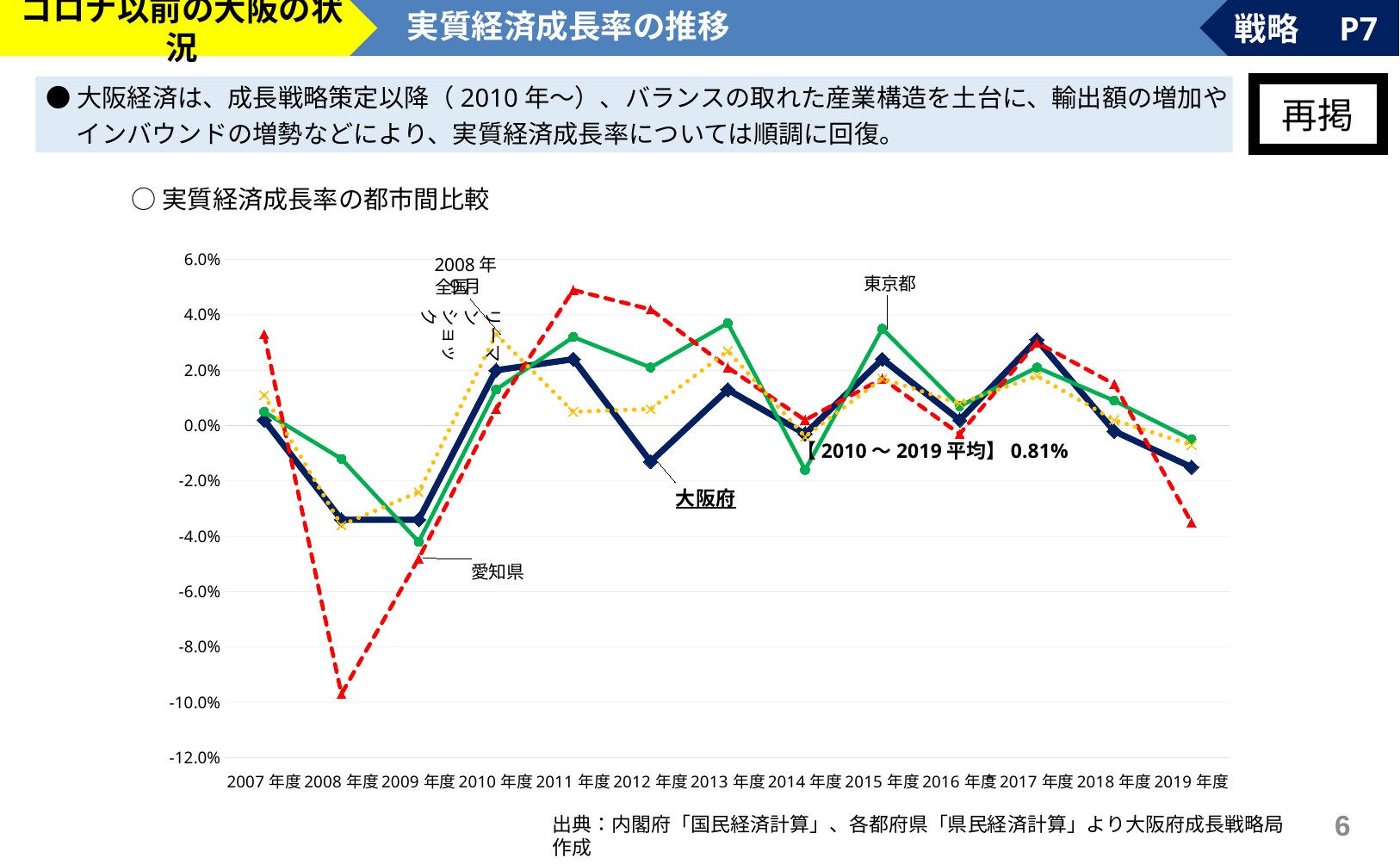
Is the value for 東京都 in 2014年度 greater or less than 0.0%? less In 2015年度, which is larger: the value for 東京都 or the value for 大阪府? 東京都 Is the value for 愛知県 in 2008年度 greater or less than -8.0%? less Which series is drawn as a red dashed line in the chart? 愛知県 Is the value for 大阪府 in 2012年度 greater or less than 0.0%? less What value is printed on the chart for the 2010～2019 average? 0.81% What is the title printed above the chart? 実質経済成長率の都市間比較 How many fiscal years are plotted along the x axis of the chart? 13 Does the value for 大阪府 rise or fall from 2017年度 to 2019年度? fall In which fiscal year does 愛知県 reach its lowest value in the chart? 2008年度 What kind of chart is shown on the slide? line chart